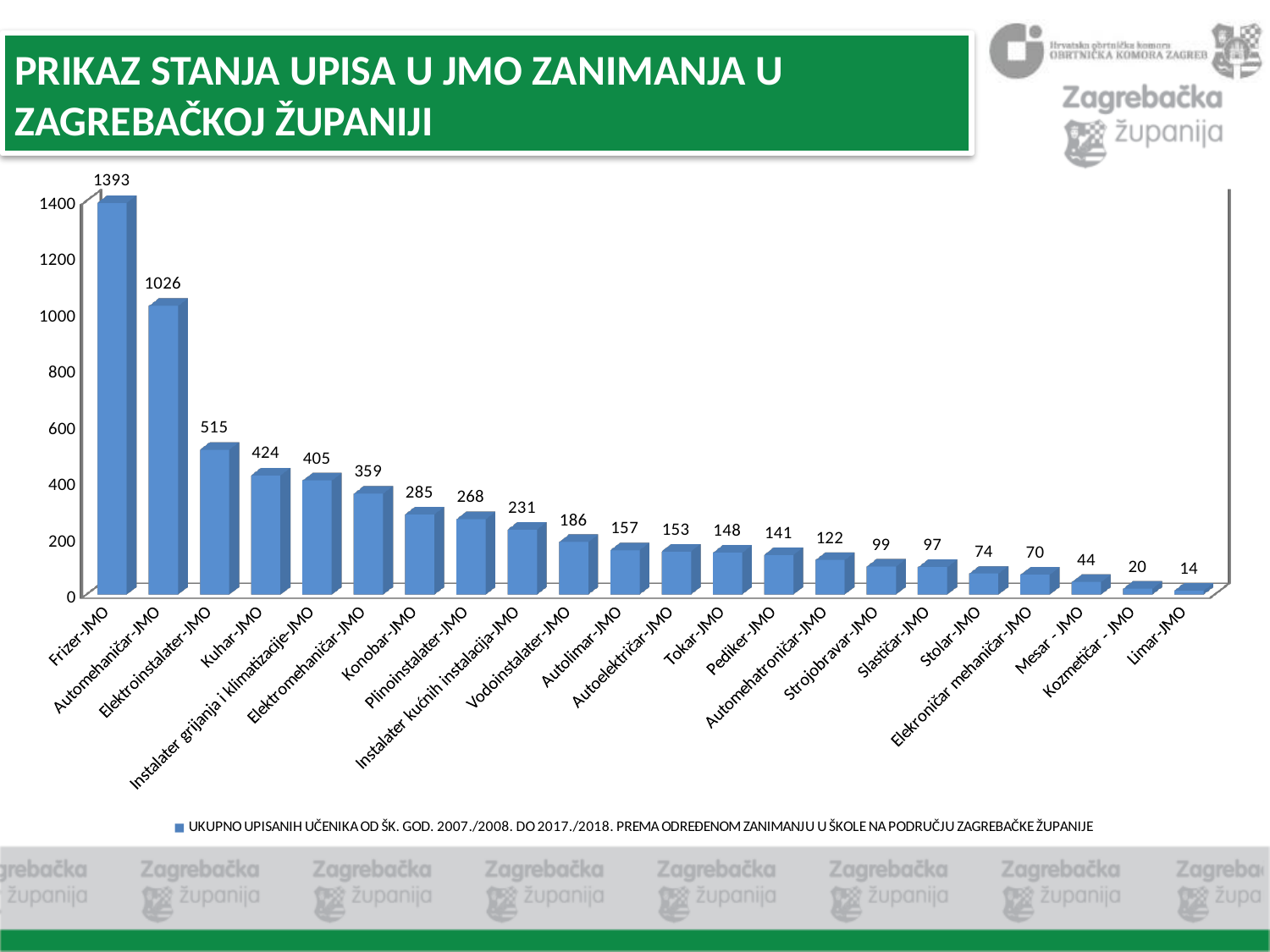
How many series does the legend list? 1 What is the value for Vodoinstalater-JMO? 186 Which category has the highest value? Frizer-JMO Which category has the lowest value? Limar-JMO How many categories are shown on the x axis? 22 Which is larger, the value for Elektroinstalater-JMO or the value for Kuhar-JMO? Elektroinstalater-JMO What is the difference between the values for Frizer-JMO and Automehaničar-JMO? 367 What kind of chart is shown on the slide? bar chart What is the difference between the values for Konobar-JMO and Plinoinstalater-JMO? 17 Is the value for Elektromehaničar-JMO greater or less than 400? less What is the value for Kuhar-JMO? 424 What is the value for Frizer-JMO? 1393